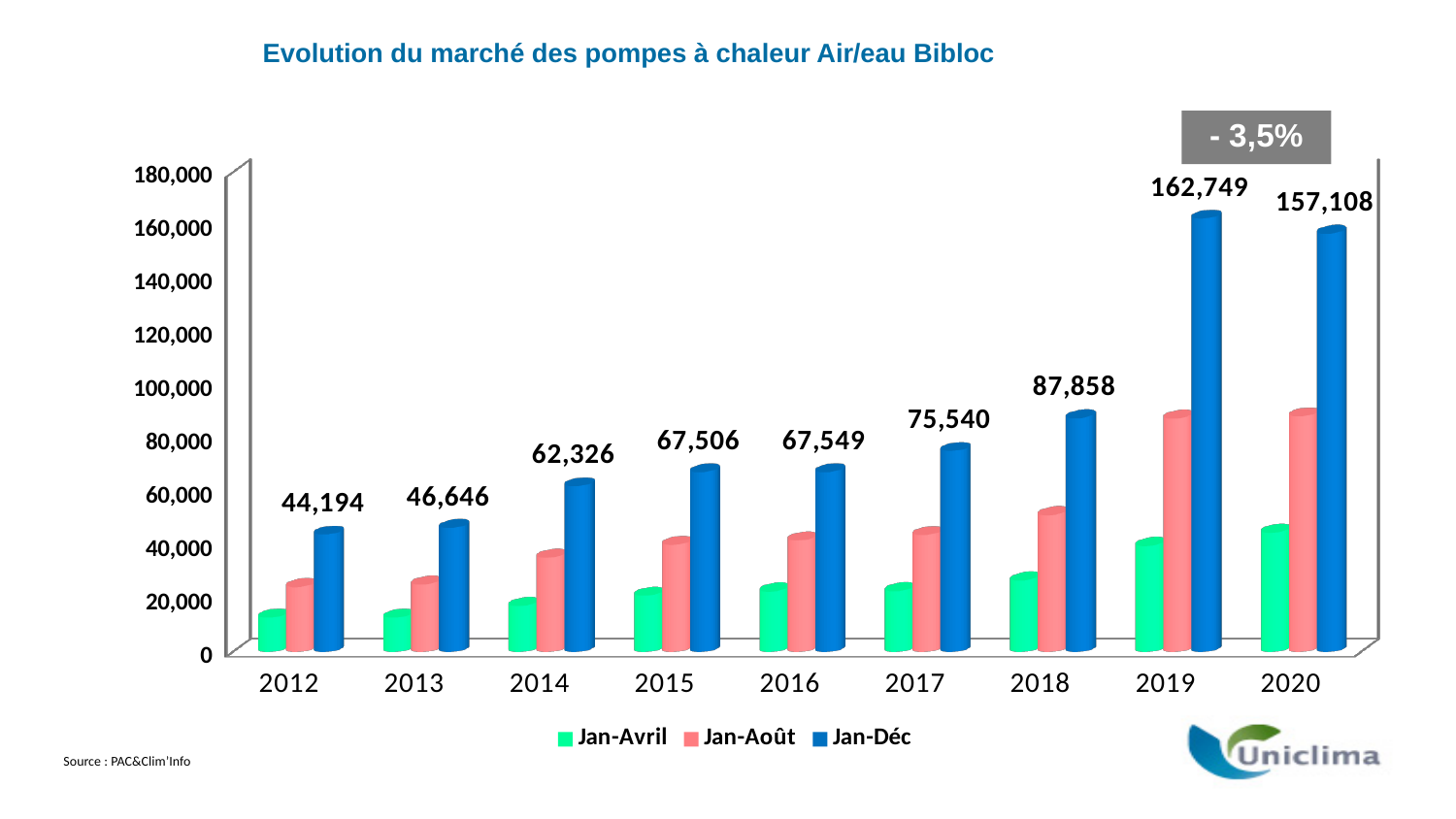
What is the Jan-Déc value for 2019? 162,749 How many series does the legend list? 3 Which year has the highest Jan-Déc value? 2019 By how much did the Jan-Déc value increase from 2017 to 2018? 12,318 How many years are shown on the x axis? 9 Which year has the lowest Jan-Déc value? 2012 What percentage change is shown in the grey box above the 2019 and 2020 bars? - 3,5% What kind of chart is shown on the slide? bar chart What is the Jan-Déc value for 2012? 44,194 Is the Jan-Août value for 2019 greater or less than 60,000? greater Which year has the larger Jan-Déc value, 2013 or 2014? 2014 What is the difference between the Jan-Déc values for 2019 and 2020? 5,641